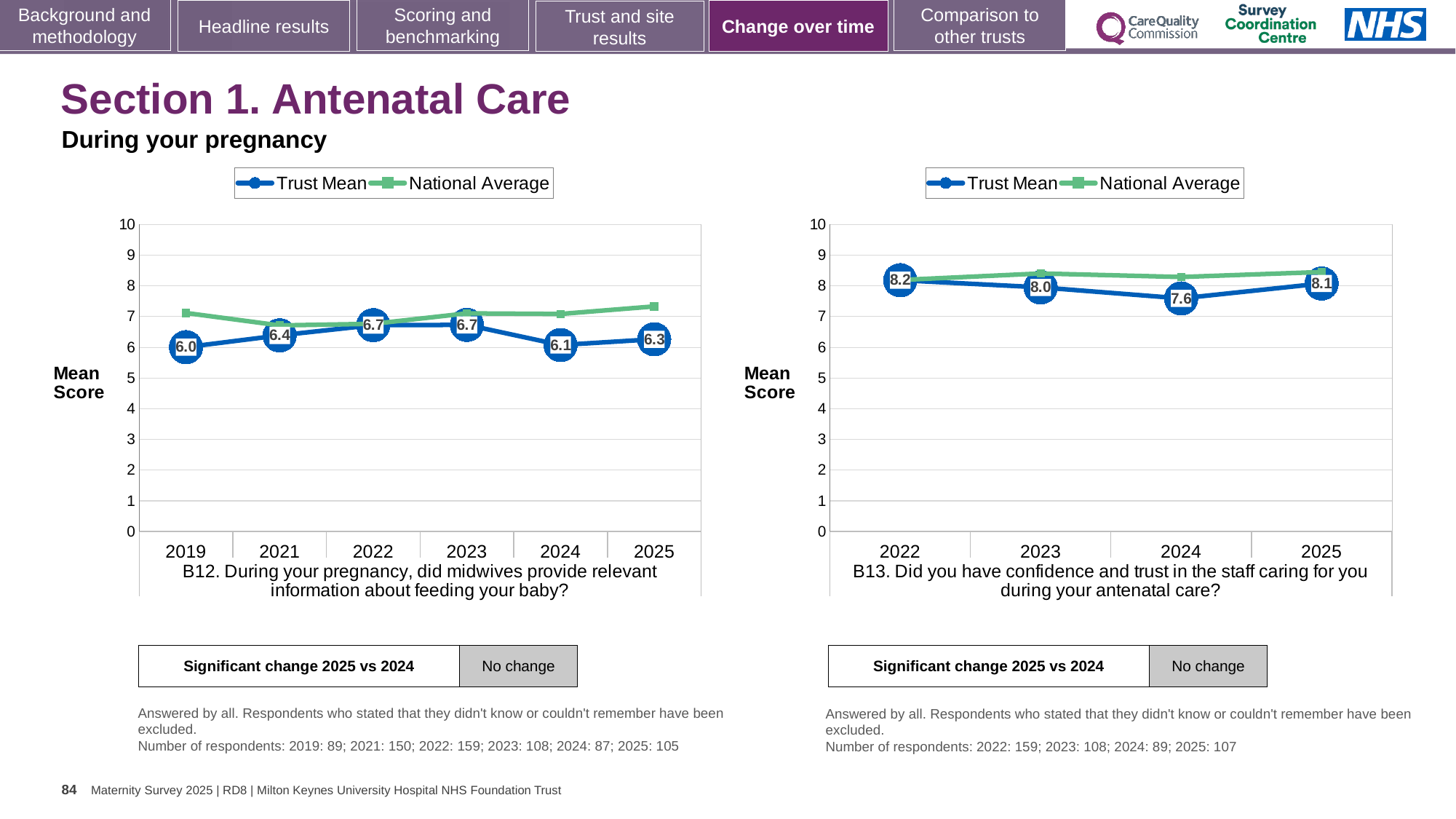
In the B13 chart (right), what is the Trust Mean score for 2024? 7.6 In the B12 chart (left), what is the Trust Mean score for 2024? 6.1 In the B13 chart (right), which year has the highest Trust Mean score? 2022 What type of chart is the B13 chart (right)? Line chart How many years are plotted on the x axis of the B12 chart (left)? 6 In the B13 chart (right), what is the difference between the Trust Mean scores for 2022 and 2024? 0.6 In the B12 chart (left), is the National Average for 2025 greater or less than 7? greater How many series does the legend of the B13 chart (right) list? 2 In the B12 chart (left), is the Trust Mean score for 2021 or 2025 larger? 2021 In the B12 chart (left), what is the Trust Mean score for 2019? 6.0 In the B12 chart (left), which year has the lowest Trust Mean score? 2019 In the B13 chart (right), what is the Trust Mean score for 2025? 8.1